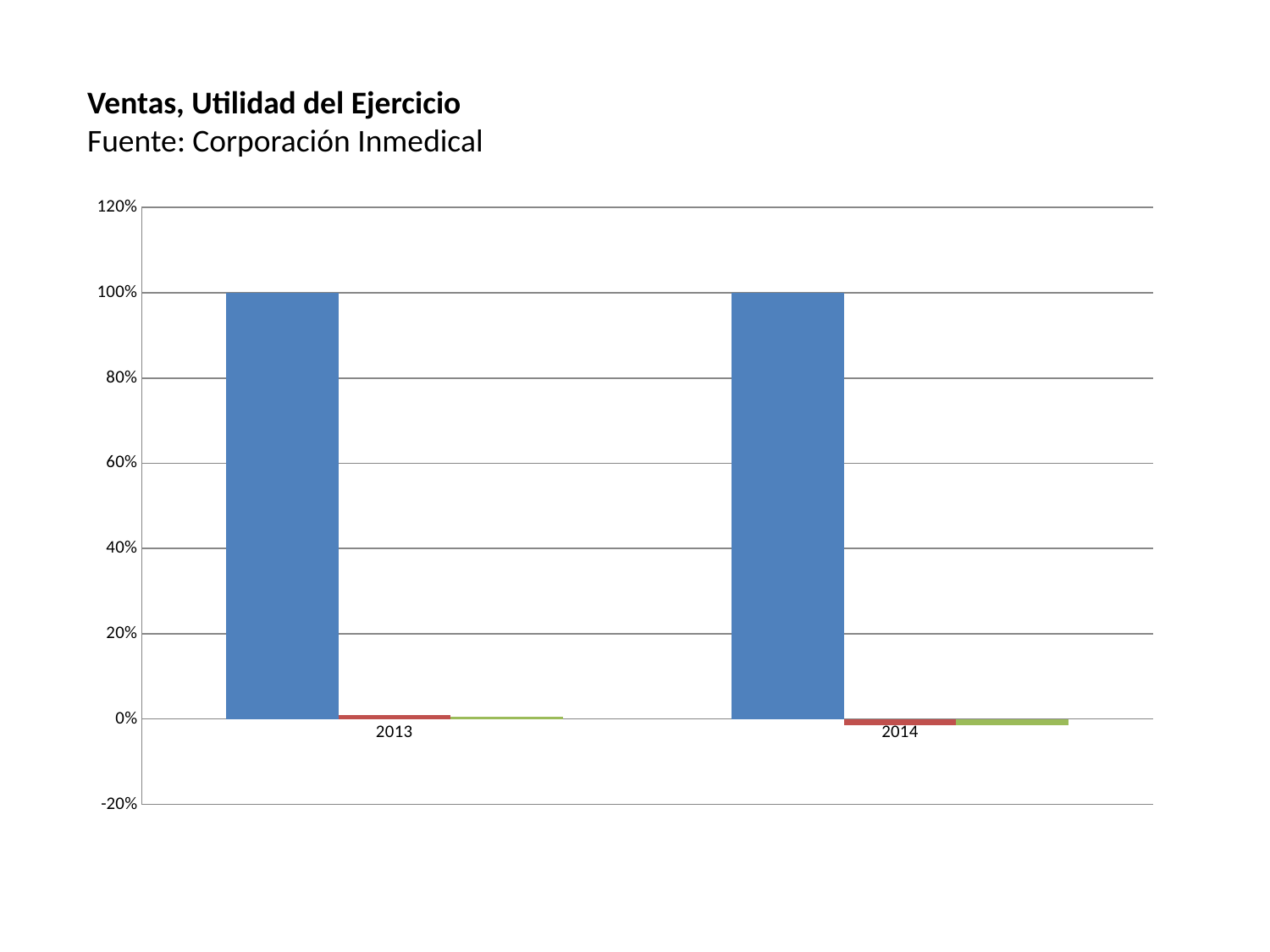
Which is larger in 2013, the blue bar or the red bar? the blue bar Is the value of the green bar for 2014 greater or less than 0%? less What is the value of the blue bar for 2014? 100% Does the red series rise or fall from 2013 to 2014? fall What kind of chart is shown on the slide? bar chart What is the value of the blue bar for 2013? 100% Is the value of the blue bar for 2014 greater or less than 80%? greater Is the value of the red bar for 2013 greater or less than 20%? less What source is given for the chart data? Corporación Inmedical How many categories are shown on the x axis? 2 What is the title of the chart? Ventas, Utilidad del Ejercicio